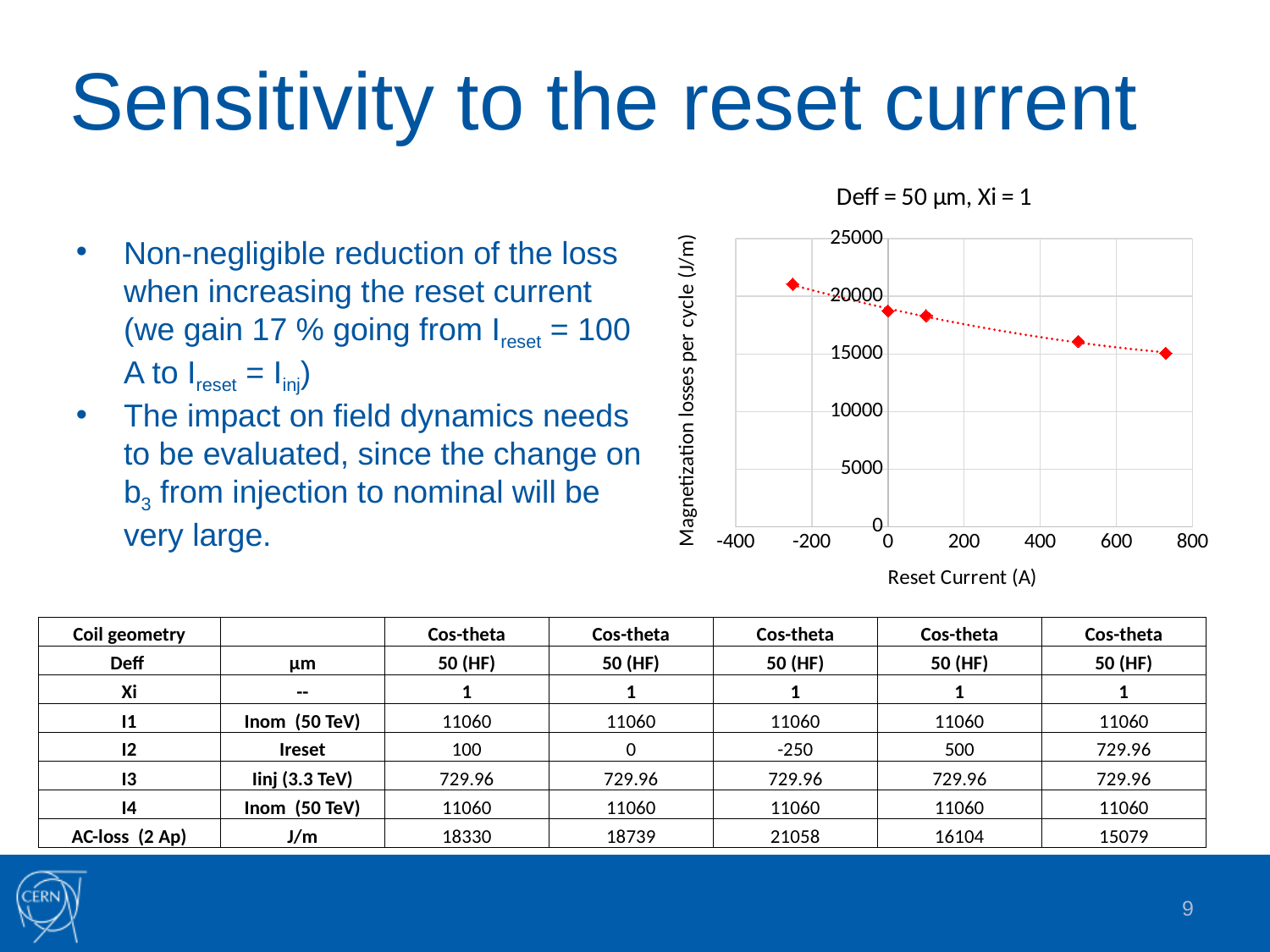
Is the magnetization loss at a reset current of 100 A greater or less than 15000 J/m? greater Do the magnetization losses rise or fall as the reset current increases along the x axis? Fall What kind of chart is shown on the slide? Scatter chart with a dotted line Is the magnetization loss at a reset current of 0 A greater or less than 20000 J/m? less At which reset current is the magnetization loss per cycle highest? -250 A What is the title of the chart? Deff = 50 μm, Xi = 1 Which has the larger magnetization loss: the point at a reset current of -250 A or the point at 500 A? -250 A Which has the smaller magnetization loss: the point at a reset current of 0 A or the point at 500 A? 500 A Is the magnetization loss at a reset current of -250 A greater or less than 20000 J/m? greater What is the label of the x axis of the chart? Reset Current (A) How many data points are plotted on the chart? 5